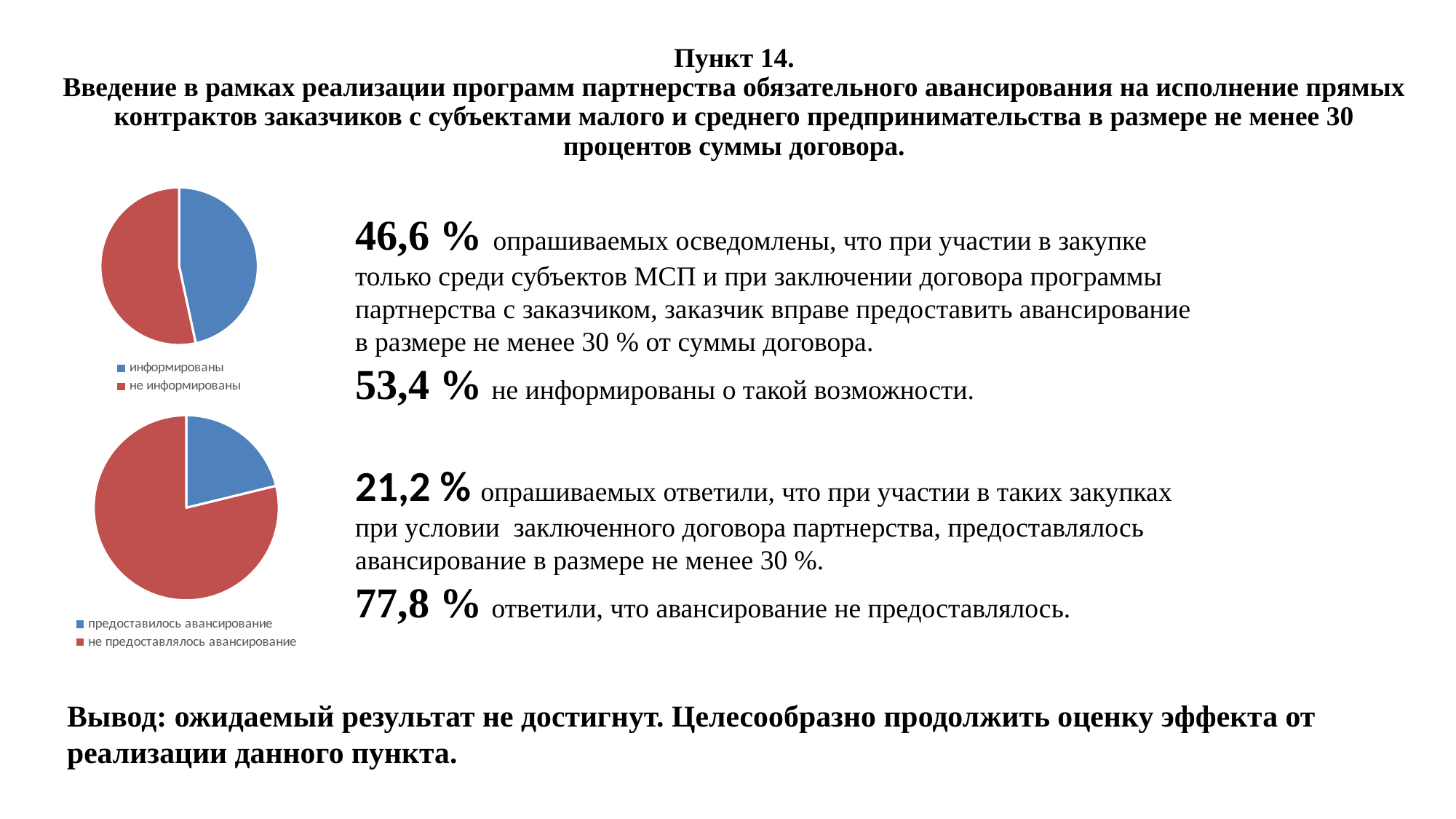
In the top pie chart, what share of respondents are 'информированы', according to the text on the slide? 46,6 % In the top pie chart, which category has the larger slice? не информированы In the top pie chart, what colour is the 'информированы' slice? blue In the bottom pie chart, which category has the smallest slice? предоставилось авансирование What kind of chart is the bottom chart on the left of the slide? pie chart In the bottom pie chart, what share corresponds to 'не предоставлялось авансирование', according to the text on the slide? 77,8 % What are the two legend entries of the bottom pie chart? предоставилось авансирование; не предоставлялось авансирование What kind of chart is the top chart on the left of the slide? pie chart In the top pie chart, what share of respondents are 'не информированы', according to the text on the slide? 53,4 % In the bottom pie chart, which slice is larger: 'предоставилось авансирование' or 'не предоставлялось авансирование'? не предоставлялось авансирование In the top pie chart, how many slices are there? 2 In the bottom pie chart, how many categories does the legend list? 2